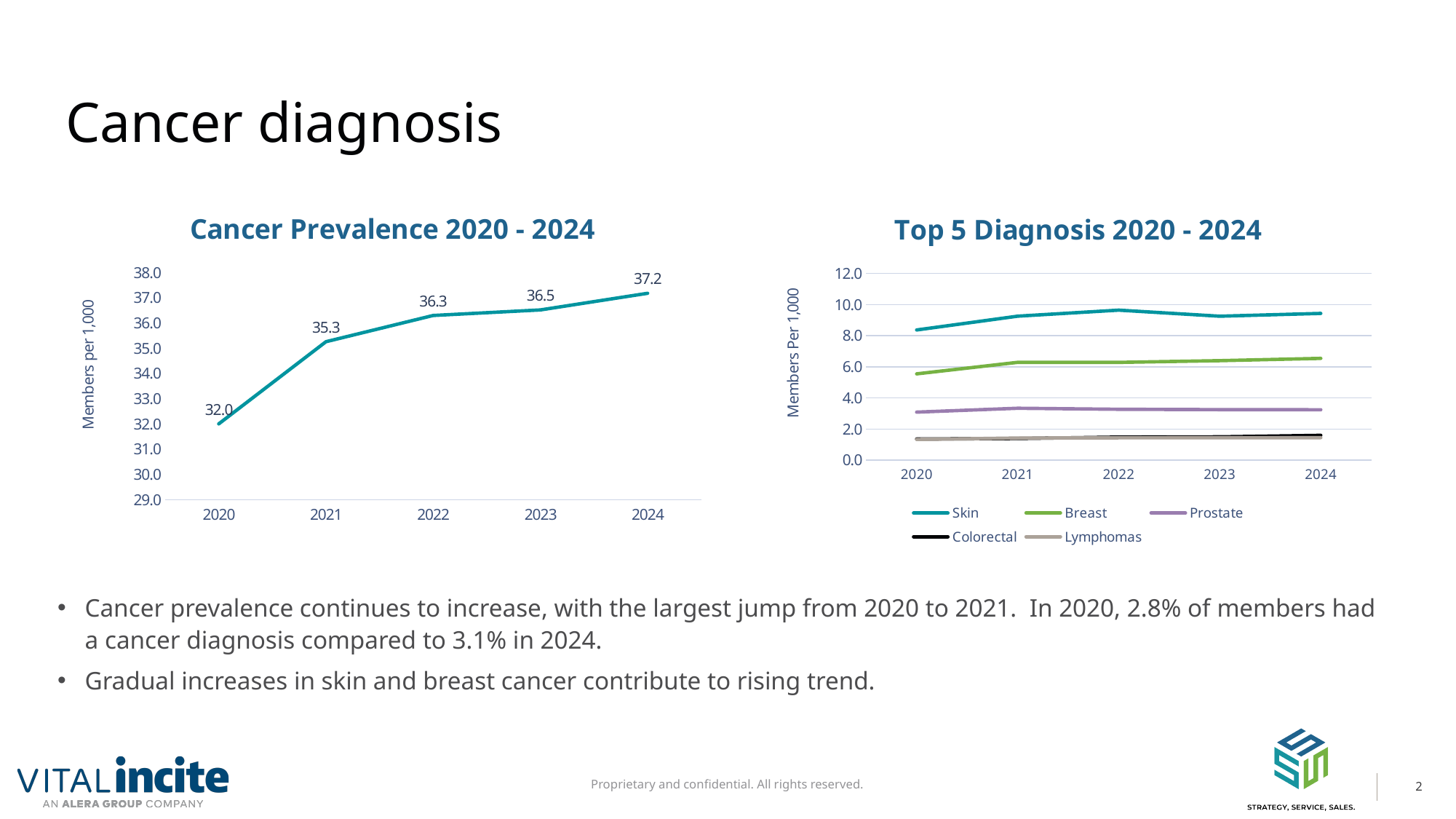
In the 'Cancer Prevalence 2020 - 2024' chart, which year has the lowest value? 2020 In the 'Cancer Prevalence 2020 - 2024' chart, what is the value for 2020? 32.0 In the 'Cancer Prevalence 2020 - 2024' chart, which year has the highest value? 2024 In the 'Cancer Prevalence 2020 - 2024' chart, how many years are plotted? 5 In the 'Cancer Prevalence 2020 - 2024' chart, what is the value for 2022? 36.3 How many series does the legend of the 'Top 5 Diagnosis 2020 - 2024' chart list? 5 In the 'Top 5 Diagnosis 2020 - 2024' chart, which series has the highest values across all years? Skin In the 'Top 5 Diagnosis 2020 - 2024' chart, is the value for Skin in 2020 greater or less than 8.0? greater In the 'Cancer Prevalence 2020 - 2024' chart, do the values rise or fall from 2020 to 2024? rise In the 'Cancer Prevalence 2020 - 2024' chart, what is the difference between the 2021 and 2020 values? 3.3 In the 'Cancer Prevalence 2020 - 2024' chart, what is the value for 2024? 37.2 What kind of chart is 'Top 5 Diagnosis 2020 - 2024'? line chart